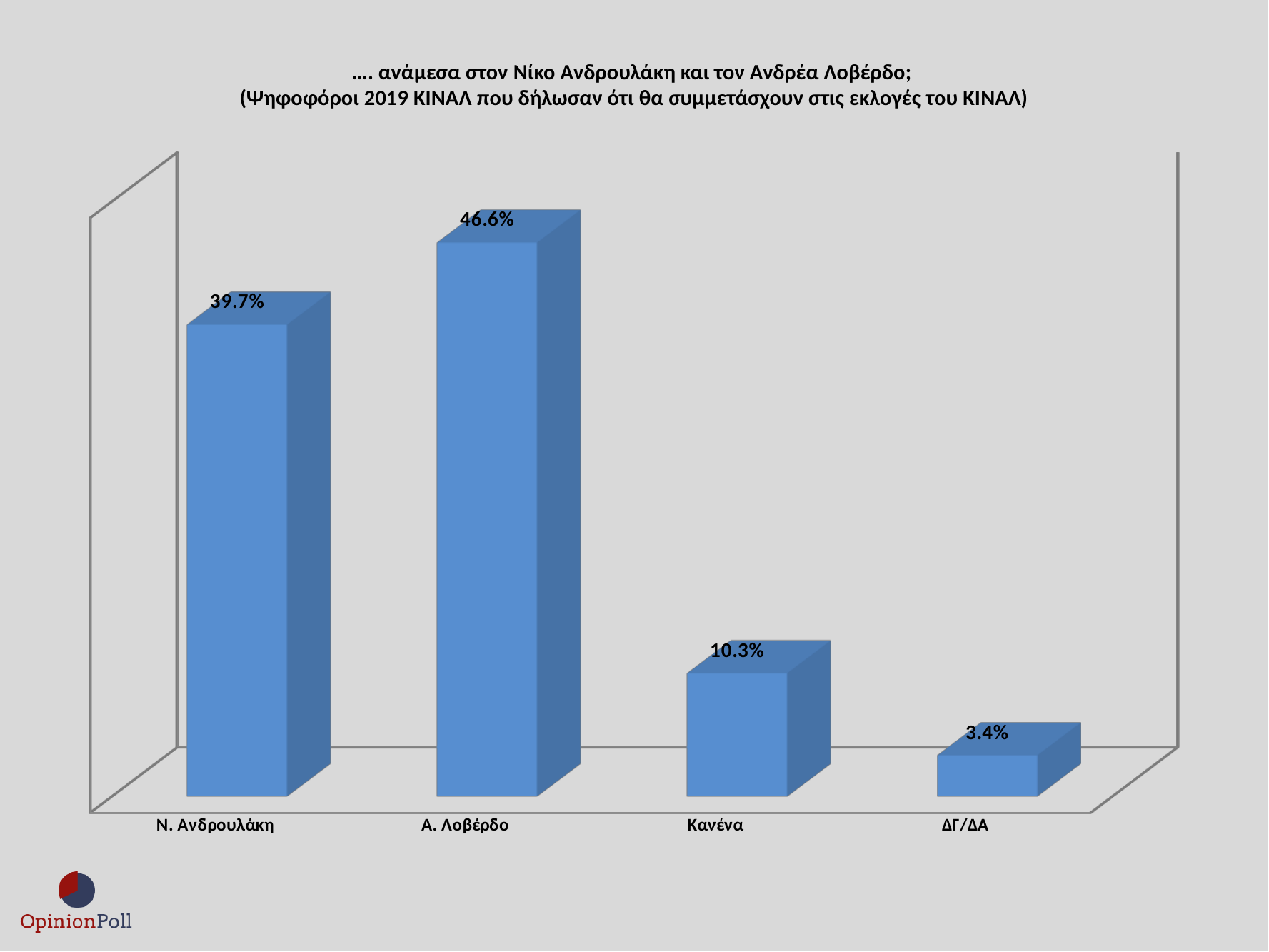
What is the difference between the values for Α. Λοβέρδο and Ν. Ανδρουλάκη? 6.9% Which category has the highest value? Α. Λοβέρδο What is the value for ΔΓ/ΔΑ? 3.4% What is the value for Α. Λοβέρδο? 46.6% What is the value for Κανένα? 10.3% What is the value for Ν. Ανδρουλάκη? 39.7% How many categories are shown on the x axis? 4 What colour are the bars in the chart? Blue What is the difference between the values for Κανένα and ΔΓ/ΔΑ? 6.9% Which category has the lowest value? ΔΓ/ΔΑ What kind of chart is shown on the slide? Bar chart Which is larger, the value for Ν. Ανδρουλάκη or the value for Κανένα? Ν. Ανδρουλάκη